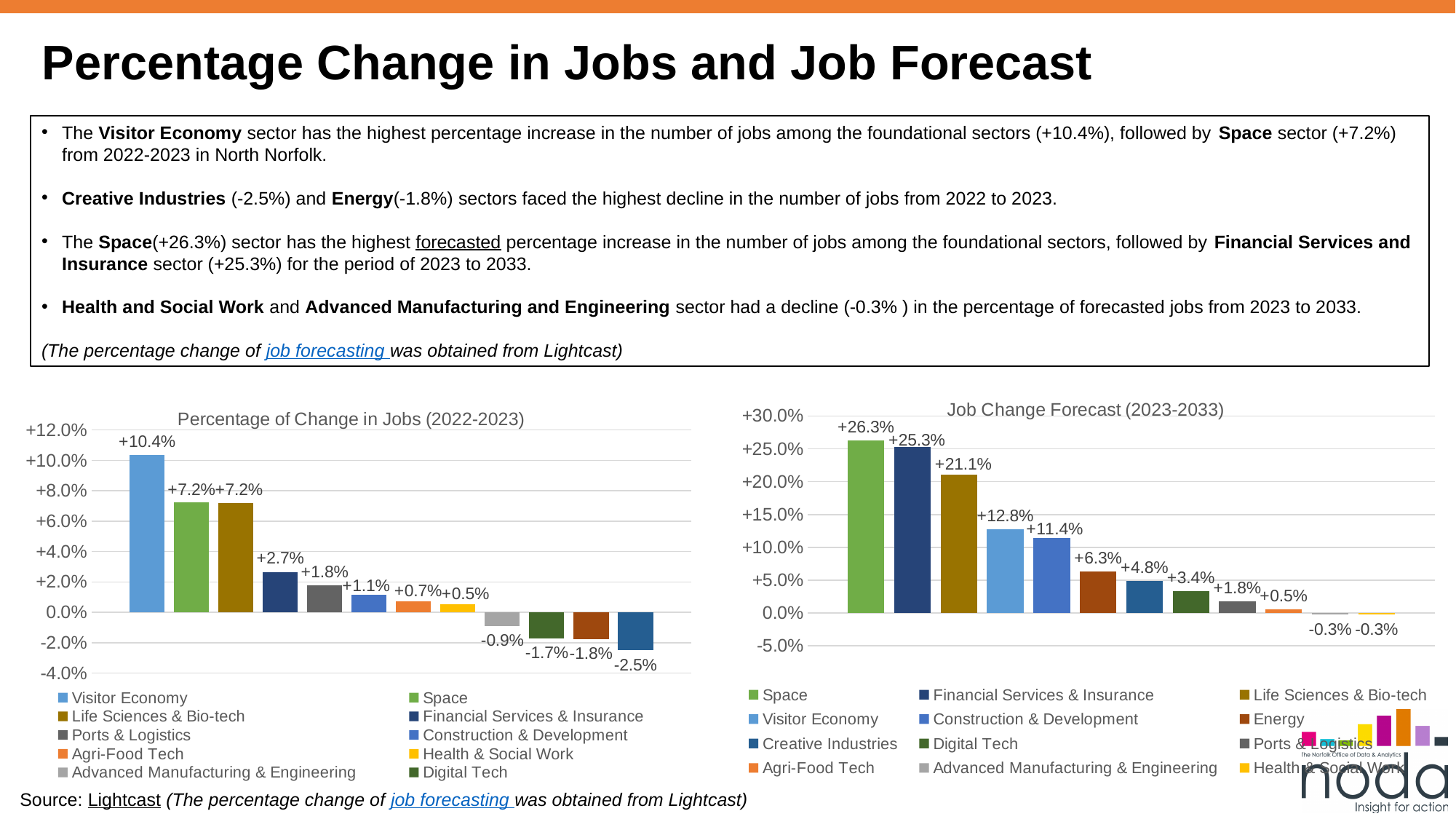
In the 'Percentage of Change in Jobs (2022-2023)' chart, what is the difference in percentage points between Visitor Economy and Space? 3.2 percentage points In the 'Job Change Forecast (2023-2033)' chart, which is larger: Visitor Economy or Construction & Development? Visitor Economy In the 'Percentage of Change in Jobs (2022-2023)' chart, which sector has the lowest value? Creative Industries What kind of chart is the 'Job Change Forecast (2023-2033)' chart? Bar chart In the 'Percentage of Change in Jobs (2022-2023)' chart, how many bars are plotted? 12 In the 'Percentage of Change in Jobs (2022-2023)' chart, what is the value for Ports & Logistics? +1.8% In the 'Job Change Forecast (2023-2033)' chart, how many entries does the legend list? 12 In the 'Job Change Forecast (2023-2033)' chart, what is the difference in percentage points between Space and Financial Services & Insurance? 1.0 percentage points In the 'Percentage of Change in Jobs (2022-2023)' chart, which sector has the highest value? Visitor Economy In the 'Job Change Forecast (2023-2033)' chart, what is the value for Life Sciences & Bio-tech? +21.1% In the 'Job Change Forecast (2023-2033)' chart, what is the value for Space? +26.3% In the 'Percentage of Change in Jobs (2022-2023)' chart, what is the value for Visitor Economy? +10.4%